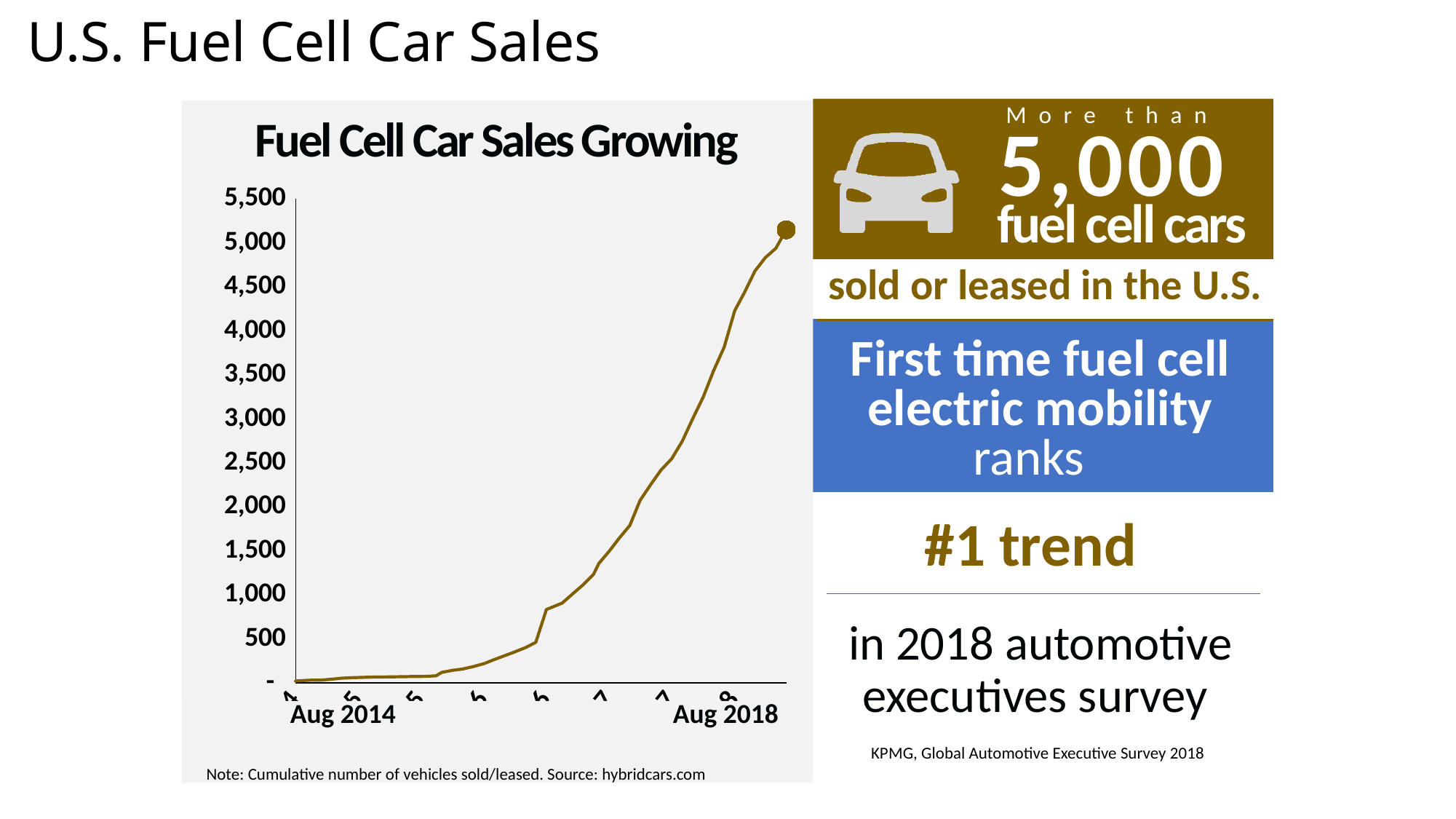
Is the value at Aug 2014 greater or less than 500? less At which labelled point on the x axis is the value lowest, Aug 2014 or Aug 2018? Aug 2014 Is the value at Aug 2018 greater or less than 4,500? greater Do the values on the chart rise or fall from Aug 2014 to Aug 2018? rise What is the highest value shown on the chart's vertical axis? 5,500 Is the value at Aug 2018 greater or less than 3,000? greater What is the title of the chart? Fuel Cell Car Sales Growing Which end of the x axis has the higher value, Aug 2014 or Aug 2018? Aug 2018 What kind of chart is shown on the slide? line chart